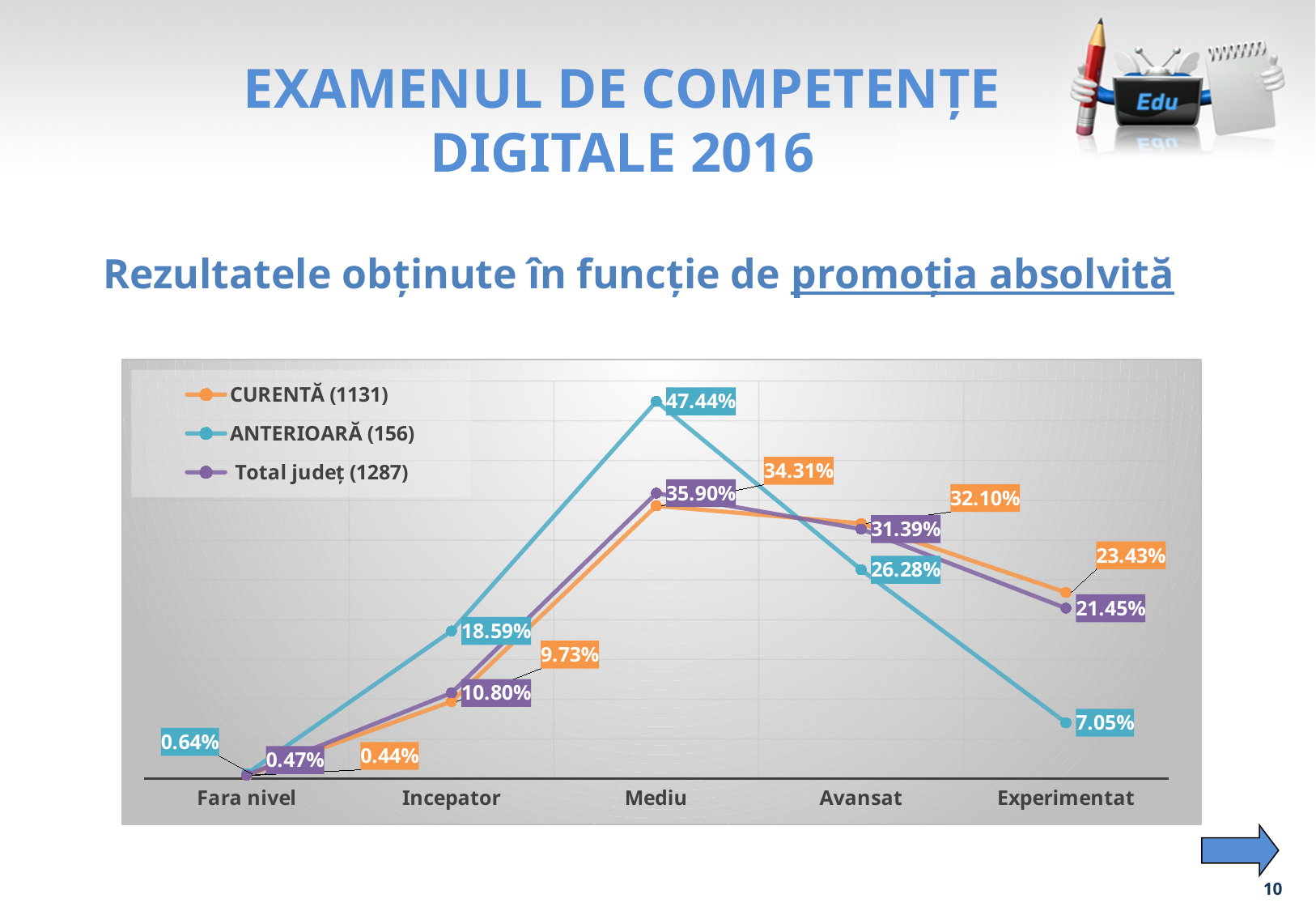
At Experimentat, which series has the larger value: CURENTĂ (1131) or ANTERIOARĂ (156)? CURENTĂ (1131) Which colour is used for the Total județ (1287) series? purple Does the ANTERIOARĂ (156) series rise or fall from Mediu to Experimentat? fall At which category does the ANTERIOARĂ (156) series reach its highest value? Mediu How many series does the legend list? 3 At which category does the CURENTĂ (1131) series have its lowest value? Fara nivel How many categories are shown on the x axis? 5 What is the value for ANTERIOARĂ (156) at Mediu? 47.44% What is the value for Total județ (1287) at Incepator? 10.80% What is the difference between the ANTERIOARĂ (156) and CURENTĂ (1131) values at Mediu? 13.13% What kind of chart is shown on the slide? line chart What is the value for CURENTĂ (1131) at Experimentat? 23.43%